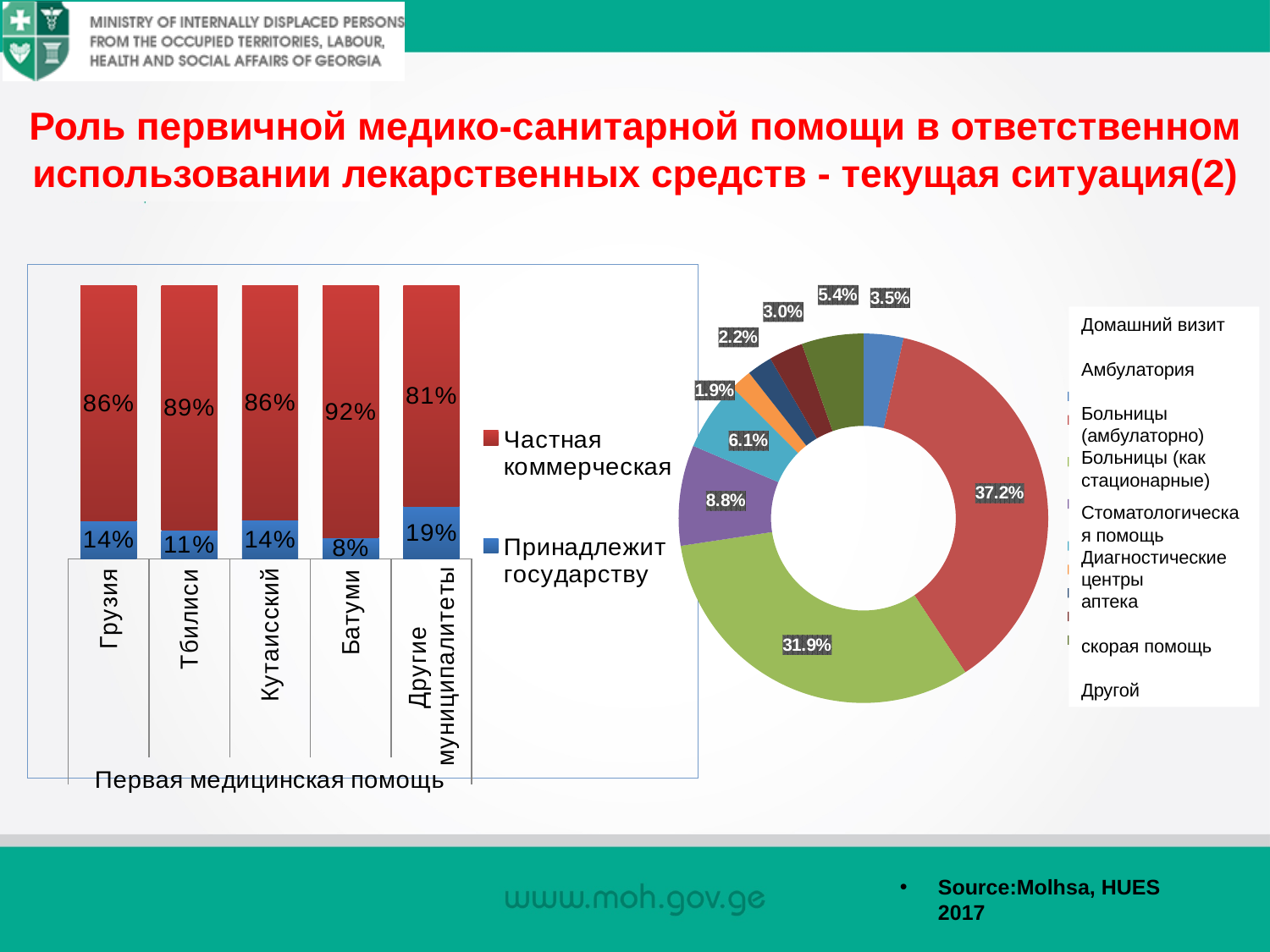
In the left bar chart, what is the difference between the Частная коммерческая values for Батуми and Тбилиси? 3% In the left bar chart, which category has the highest value for Принадлежит государству? Другие муниципалитеты In the left bar chart, which is larger: Принадлежит государству in Грузия or in Батуми? Грузия In the right doughnut chart, what is the value of the largest slice? 37.2% In the left bar chart, how many categories are shown on the x axis? 5 In the right doughnut chart, how many slices are labelled with values? 9 In the left bar chart, what is the value for Принадлежит государству in Другие муниципалитеты? 19% What type of chart is shown on the right side of the slide? Doughnut chart In the left bar chart, which category has the lowest value for Частная коммерческая? Другие муниципалитеты In the left bar chart, what is the value for Частная коммерческая in Батуми? 92% In the left bar chart, how many series does the legend list? 2 In the left bar chart, what is the value for Принадлежит государству in Тбилиси? 11%